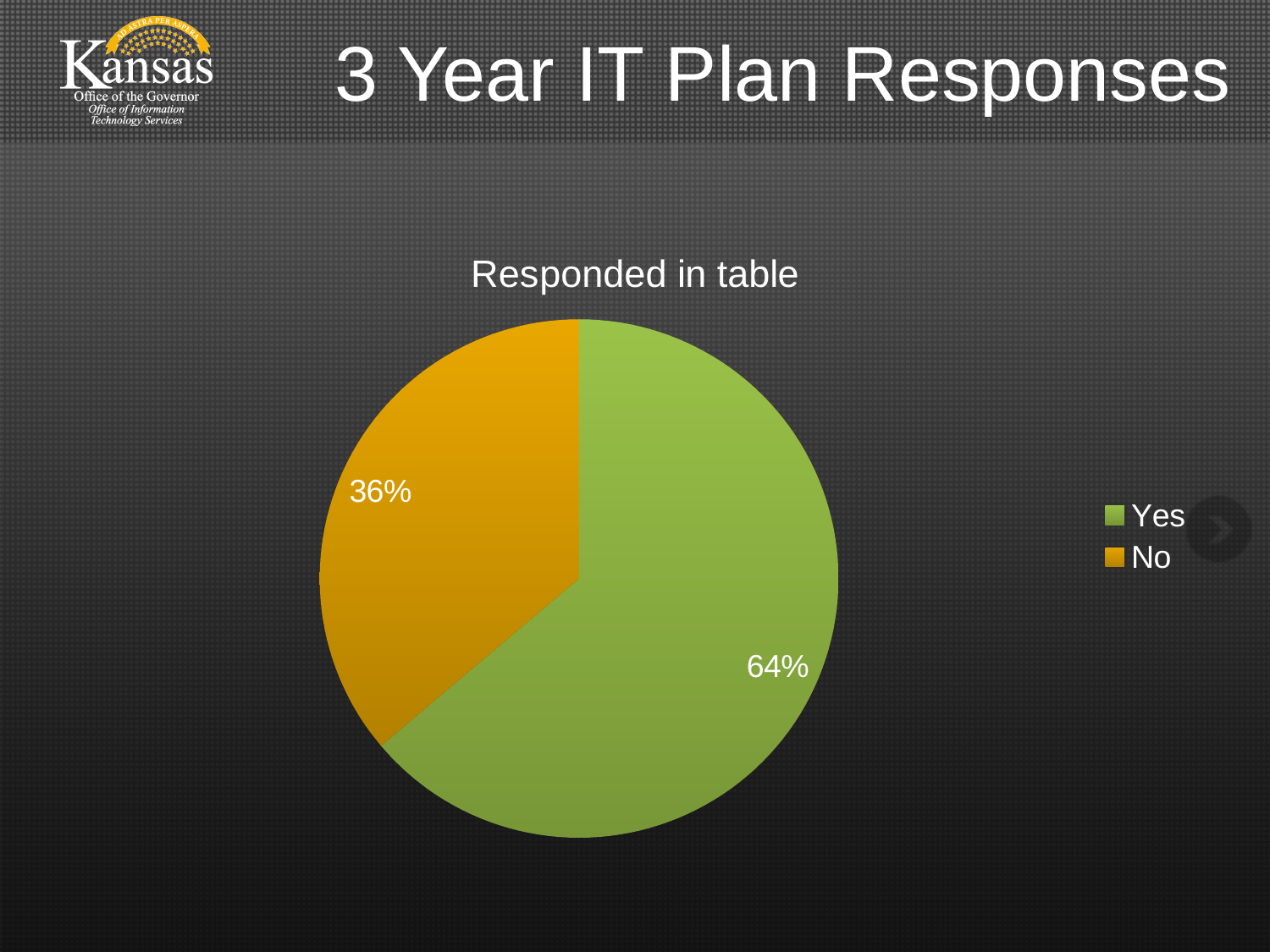
What is the title of the chart? Responded in table How many entries does the legend list? 2 How many slices does the pie chart have? 2 What type of chart is shown on the slide? pie chart Which slice is the smallest in the pie chart? No What share of the pie does the No slice represent? 36% What share of the pie does the Yes slice represent? 64% Which is larger, the Yes slice or the No slice? Yes What colour is the Yes slice? green What is the difference in percentage points between the Yes and No slices? 28 percentage points Which slice is the largest in the pie chart? Yes